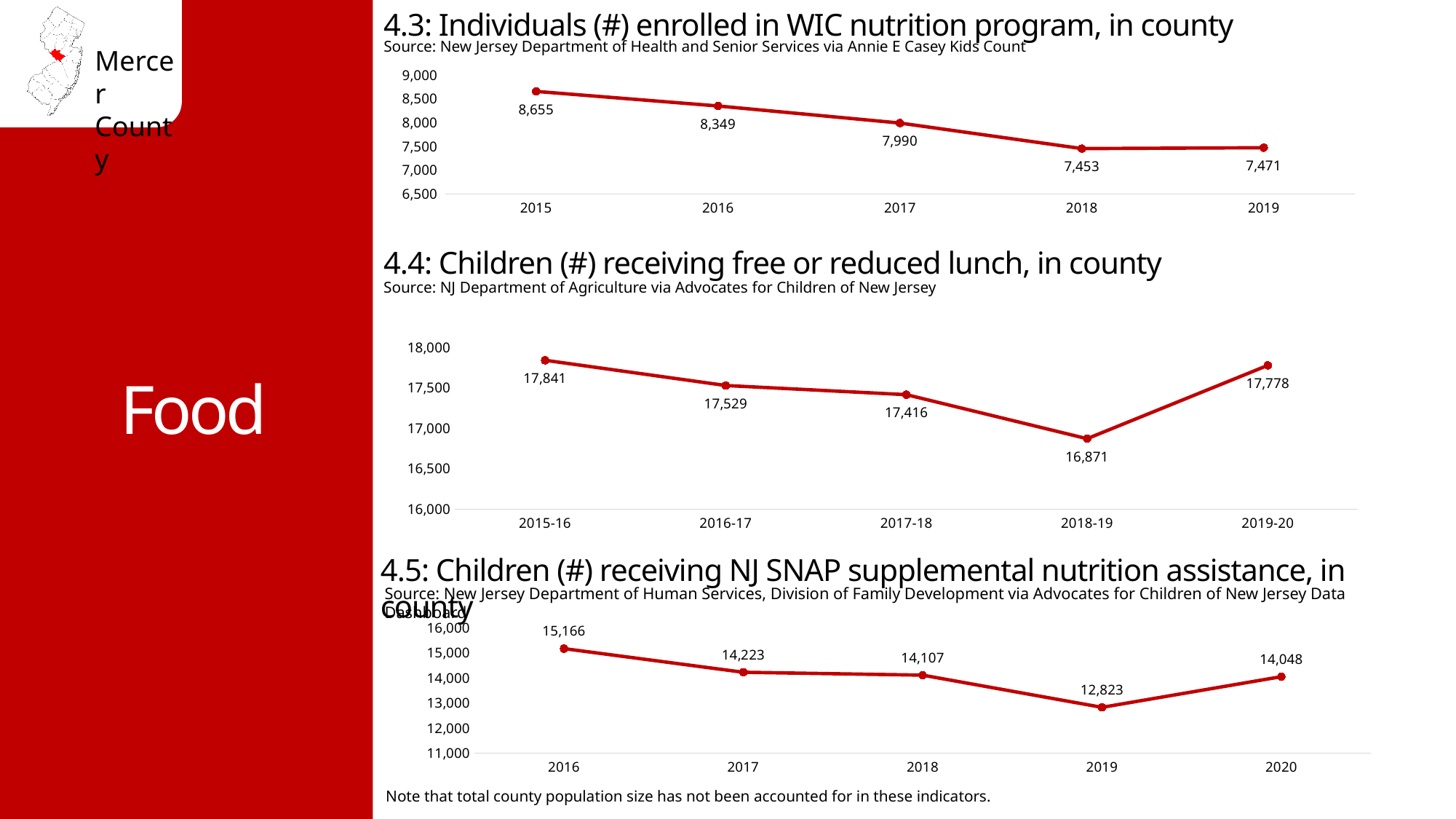
In the chart '4.5: Children (#) receiving NJ SNAP supplemental nutrition assistance, in county', is the value for 2019 greater or less than 13,000? less In the chart '4.4: Children (#) receiving free or reduced lunch, in county', which school year has the highest value? 2015-16 In the chart '4.3: Individuals (#) enrolled in WIC nutrition program, in county', which year has the lowest value? 2018 In the chart '4.3: Individuals (#) enrolled in WIC nutrition program, in county', what is the difference between the 2015 and 2019 values? 1,184 In the chart '4.5: Children (#) receiving NJ SNAP supplemental nutrition assistance, in county', which year has the lowest value? 2019 In the chart '4.3: Individuals (#) enrolled in WIC nutrition program, in county', what is the value for 2015? 8,655 In the chart '4.5: Children (#) receiving NJ SNAP supplemental nutrition assistance, in county', what is the value for 2016? 15,166 What kind of chart is '4.3: Individuals (#) enrolled in WIC nutrition program, in county'? line chart In the chart '4.4: Children (#) receiving free or reduced lunch, in county', is the value for 2016-17 larger or smaller than the value for 2019-20? smaller In the chart '4.4: Children (#) receiving free or reduced lunch, in county', what is the value for 2018-19? 16,871 In the chart '4.4: Children (#) receiving free or reduced lunch, in county', what is the difference between the 2019-20 and 2018-19 values? 907 In the chart '4.3: Individuals (#) enrolled in WIC nutrition program, in county', how many years are plotted? 5